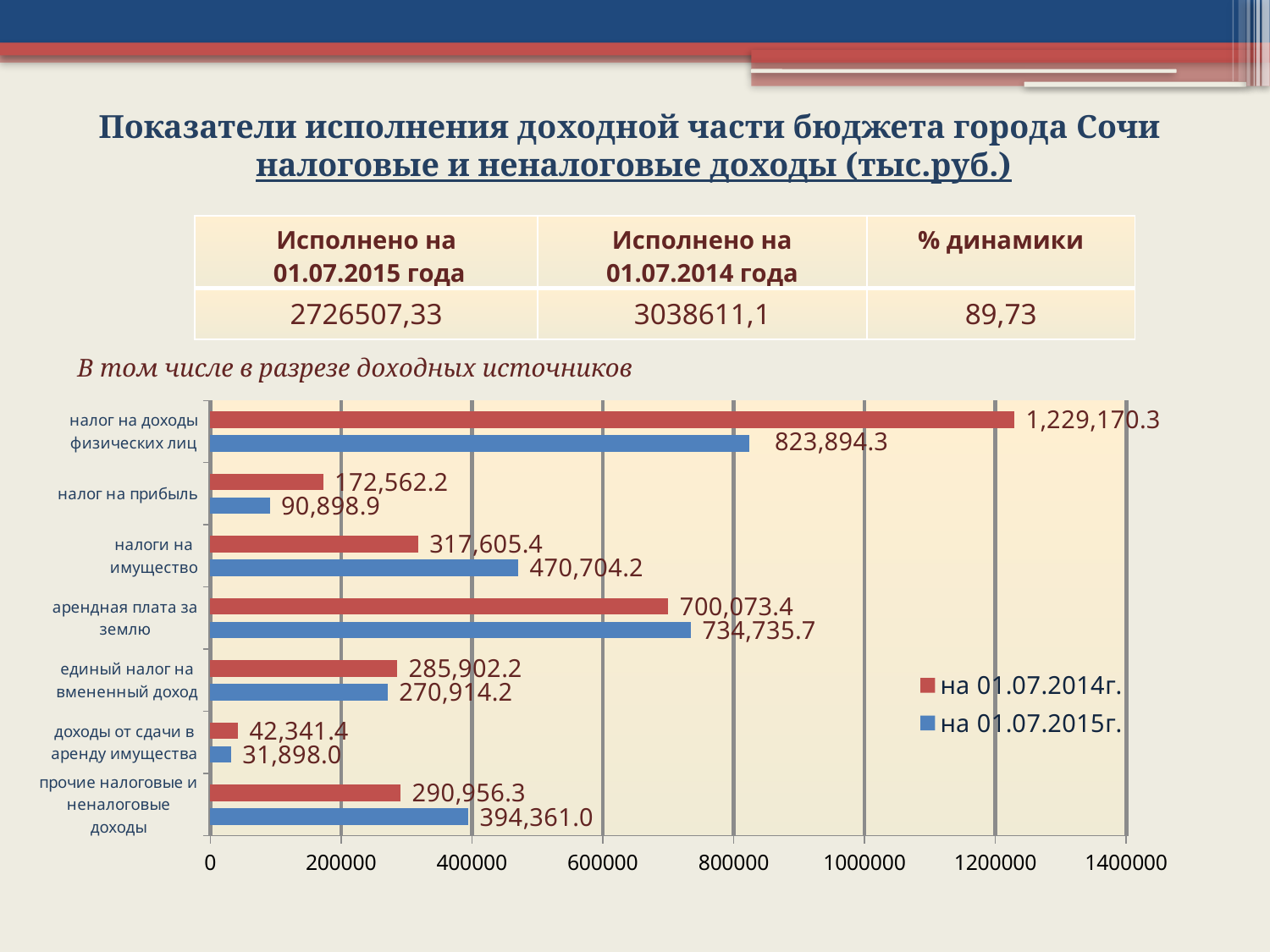
Which category has the lowest value in the series на 01.07.2014г.? доходы от сдачи в аренду имущества How many series does the legend list? 2 What is the value for доходы от сдачи в аренду имущества in the series на 01.07.2014г.? 42,341.4 What is the value for прочие налоговые и неналоговые доходы in the series на 01.07.2015г.? 394,361.0 What kind of chart is shown on the slide? bar chart What is the value for налог на доходы физических лиц in the series на 01.07.2014г.? 1,229,170.3 For единый налог на вмененный доход, which series has the larger value: на 01.07.2014г. or на 01.07.2015г.? на 01.07.2014г. What is the value for налог на прибыль in the series на 01.07.2015г.? 90,898.9 What is the difference between the на 01.07.2015г. and на 01.07.2014г. values for налоги на имущество? 153,098.8 How many categories are shown on the chart? 7 Which category has the highest value in the series на 01.07.2015г.? налог на доходы физических лиц What is the difference between the на 01.07.2015г. and на 01.07.2014г. values for арендная плата за землю? 34,662.3